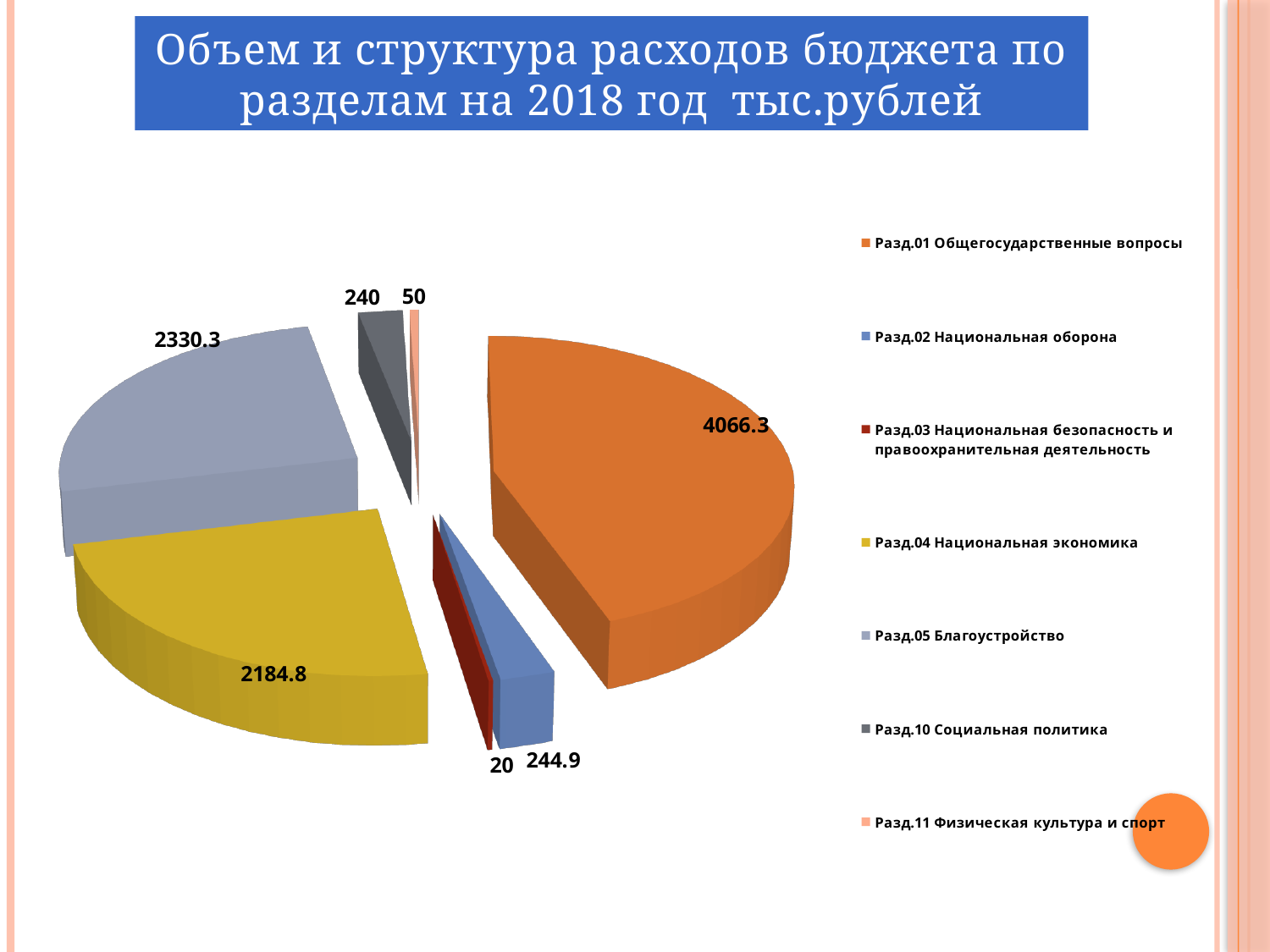
What is the value for Разд.02 Национальная оборона? 244.9 Which section has the smallest value? Разд.03 Национальная безопасность и правоохранительная деятельность What is the value for Разд.11 Физическая культура и спорт? 50 Which is larger: the value for Разд.10 Социальная политика or Разд.02 Национальная оборона? Разд.02 Национальная оборона Which section has the largest share of the budget expenses? Разд.01 Общегосударственные вопросы What is the difference between the values for Разд.05 Благоустройство and Разд.04 Национальная экономика? 145.5 What is the value for Разд.01 Общегосударственные вопросы? 4066.3 How many sections (slices) does the pie chart show? 7 What type of chart is shown on the slide? pie chart What is the title of the chart on the slide? Объем и структура расходов бюджета по разделам на 2018 год тыс.рублей What is the value for Разд.04 Национальная экономика? 2184.8 What is the value for Разд.05 Благоустройство? 2330.3